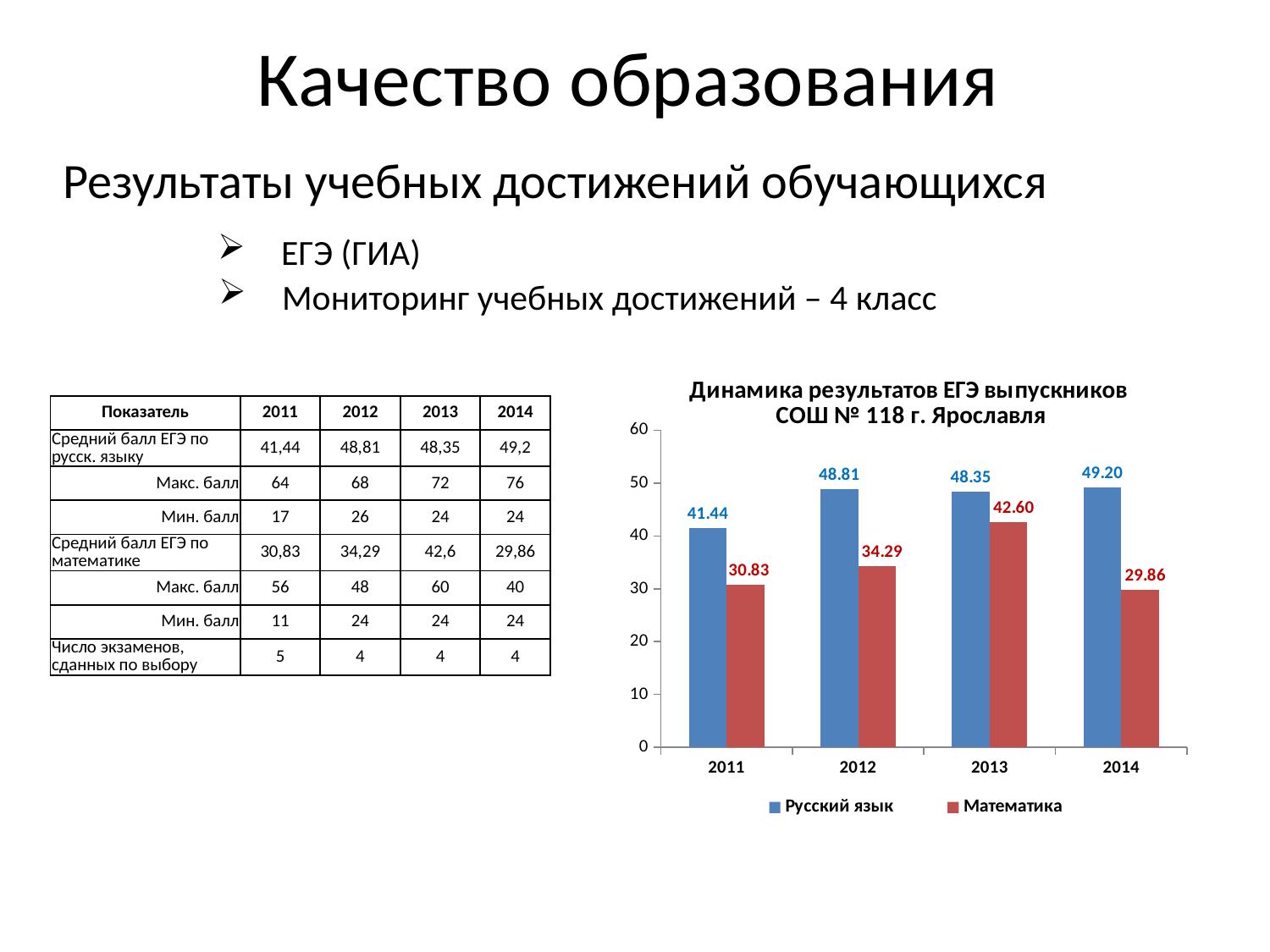
In which year is the value for Русский язык the highest? 2014 What is the value for Математика in 2014? 29.86 In which year is the value for Математика the lowest? 2014 What is the difference between Русский язык and Математика in 2011? 10.61 How many years are shown on the x axis? 4 How many series does the legend list? 2 Which is larger in 2013: Русский язык or Математика? Русский язык What kind of chart is shown on the slide? bar chart What is the value for Математика in 2013? 42.60 What is the title of the chart? Динамика результатов ЕГЭ выпускников СОШ № 118 г. Ярославля What is the value for Русский язык in 2012? 48.81 Is the value for Математика in 2012 greater or less than 40? less